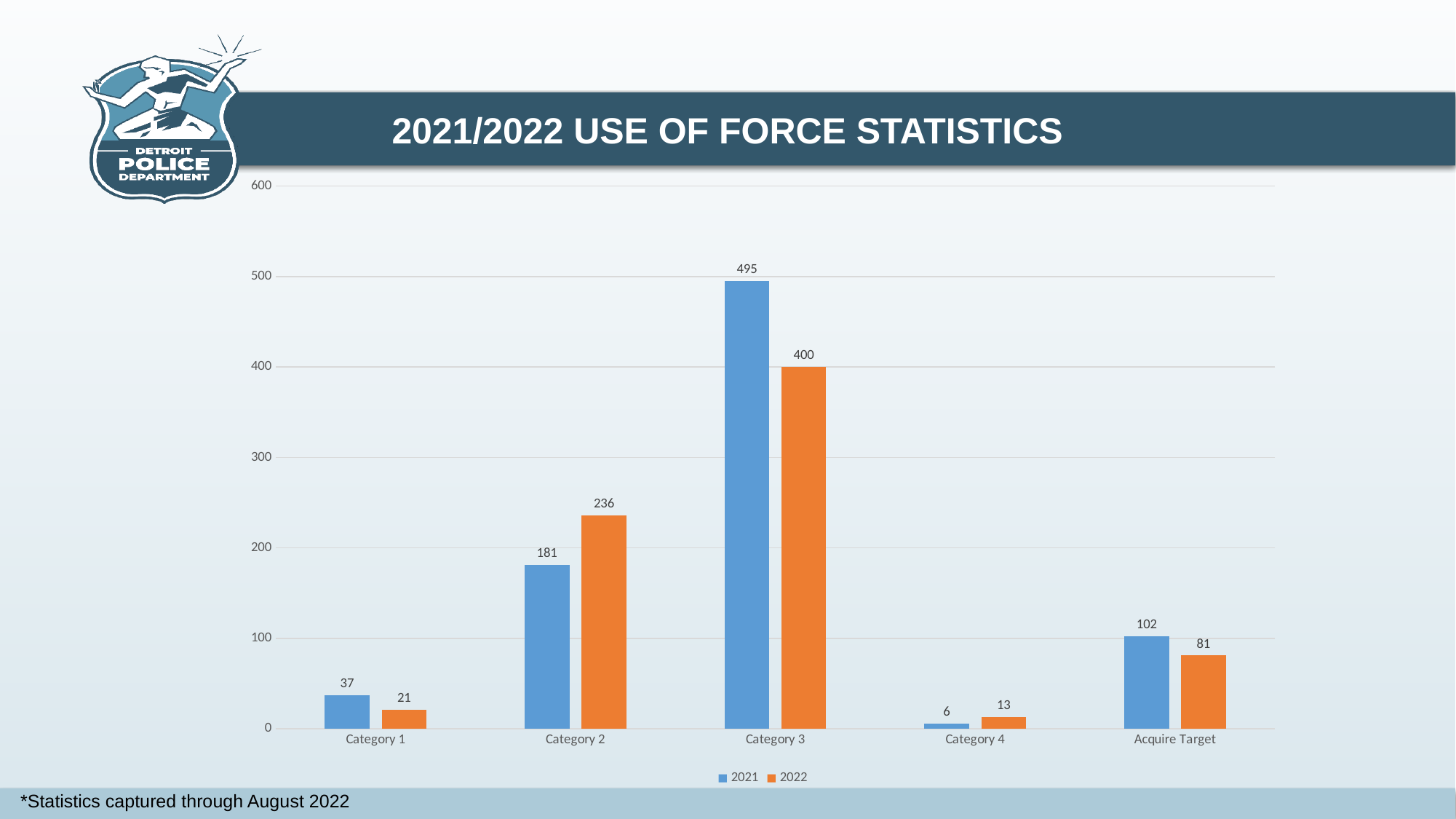
Which is larger for Category 2, the 2021 value or the 2022 value? 2022 What is the 2022 value for Category 2? 236 What is the 2022 value for Acquire Target? 81 What is the title of the chart? 2021/2022 USE OF FORCE STATISTICS Is the 2021 value for Acquire Target greater or less than 100? greater How many series does the legend list? 2 What is the 2021 value for Category 3? 495 What is the difference between the 2021 and 2022 values for Category 3? 95 What kind of chart is shown on the slide? bar chart Which category has the highest 2021 value? Category 3 How many categories are shown on the x axis? 5 Which category has the lowest 2022 value? Category 4